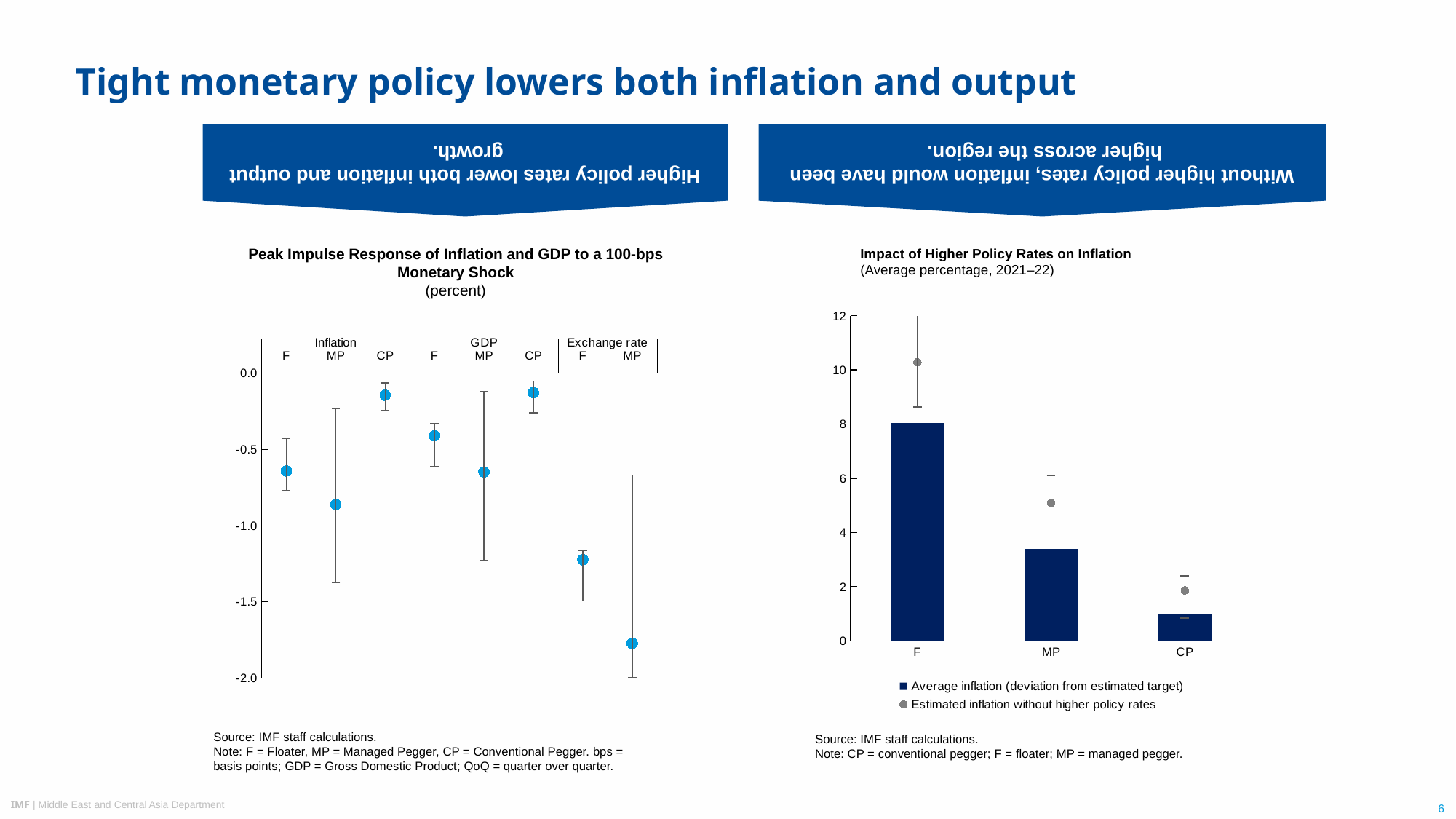
In the 'Impact of Higher Policy Rates on Inflation' chart, is the average inflation bar for MP larger or smaller than the bar for CP? larger In the 'Impact of Higher Policy Rates on Inflation' chart, is the estimated inflation without higher policy rates for F greater or less than 10? greater In the 'Impact of Higher Policy Rates on Inflation' chart, how many series does the legend list? 2 What is the subtitle shown under the title of the 'Impact of Higher Policy Rates on Inflation' chart? (Average percentage, 2021–22) In the 'Impact of Higher Policy Rates on Inflation' chart, how many categories are shown on the x axis? 3 In the 'Peak Impulse Response of Inflation and GDP to a 100-bps Monetary Shock' chart, is the Inflation CP point greater or less than -0.5? greater In the 'Peak Impulse Response of Inflation and GDP to a 100-bps Monetary Shock' chart, which point has the lowest value? Exchange rate MP In the 'Impact of Higher Policy Rates on Inflation' chart, which category has the tallest bar for average inflation? F In the 'Impact of Higher Policy Rates on Inflation' chart, is the average inflation bar for CP greater or less than 2? less In the 'Impact of Higher Policy Rates on Inflation' chart, which category has the shortest bar for average inflation? CP